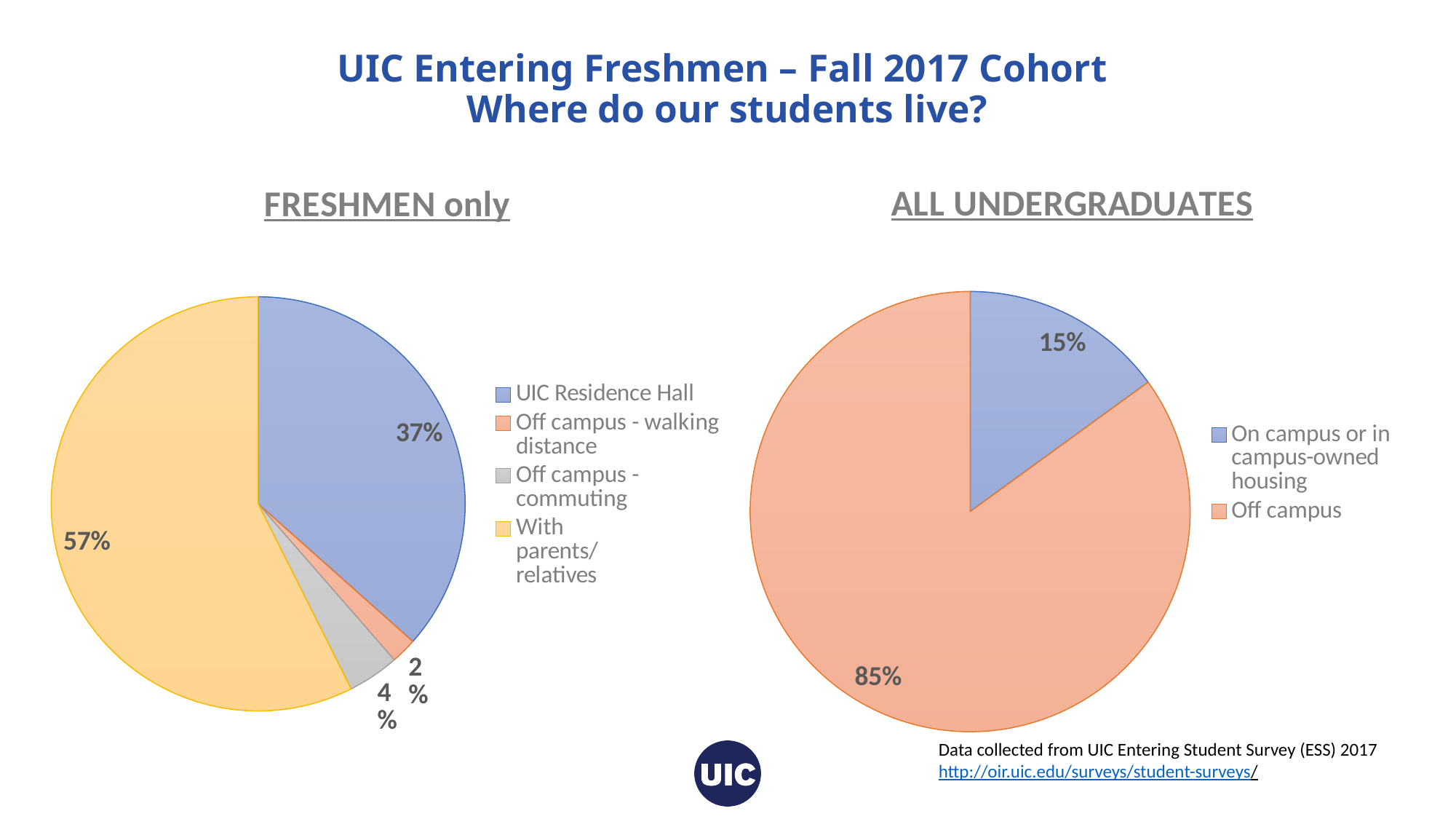
In the FRESHMEN only chart, what colour is the slice for students living with parents/relatives? Yellow In the ALL UNDERGRADUATES chart, what percentage of students live off campus? 85% In the ALL UNDERGRADUATES chart, what percentage of students live on campus or in campus-owned housing? 15% In the ALL UNDERGRADUATES chart, which is larger: the share living off campus or the share on campus or in campus-owned housing? Off campus In the FRESHMEN only chart, what is the difference in percentage points between students living with parents/relatives and those in a UIC Residence Hall? 20 What type of chart is used for the ALL UNDERGRADUATES chart? Pie chart In the FRESHMEN only chart, what percentage of students live off campus - commuting? 4% In the FRESHMEN only chart, what percentage of students live with parents/relatives? 57% How many categories does the legend of the FRESHMEN only chart list? 4 In the FRESHMEN only chart, what percentage of students live in a UIC Residence Hall? 37% In the FRESHMEN only chart, which category has the smallest share? Off campus - walking distance In the FRESHMEN only chart, which category has the largest share? With parents/relatives